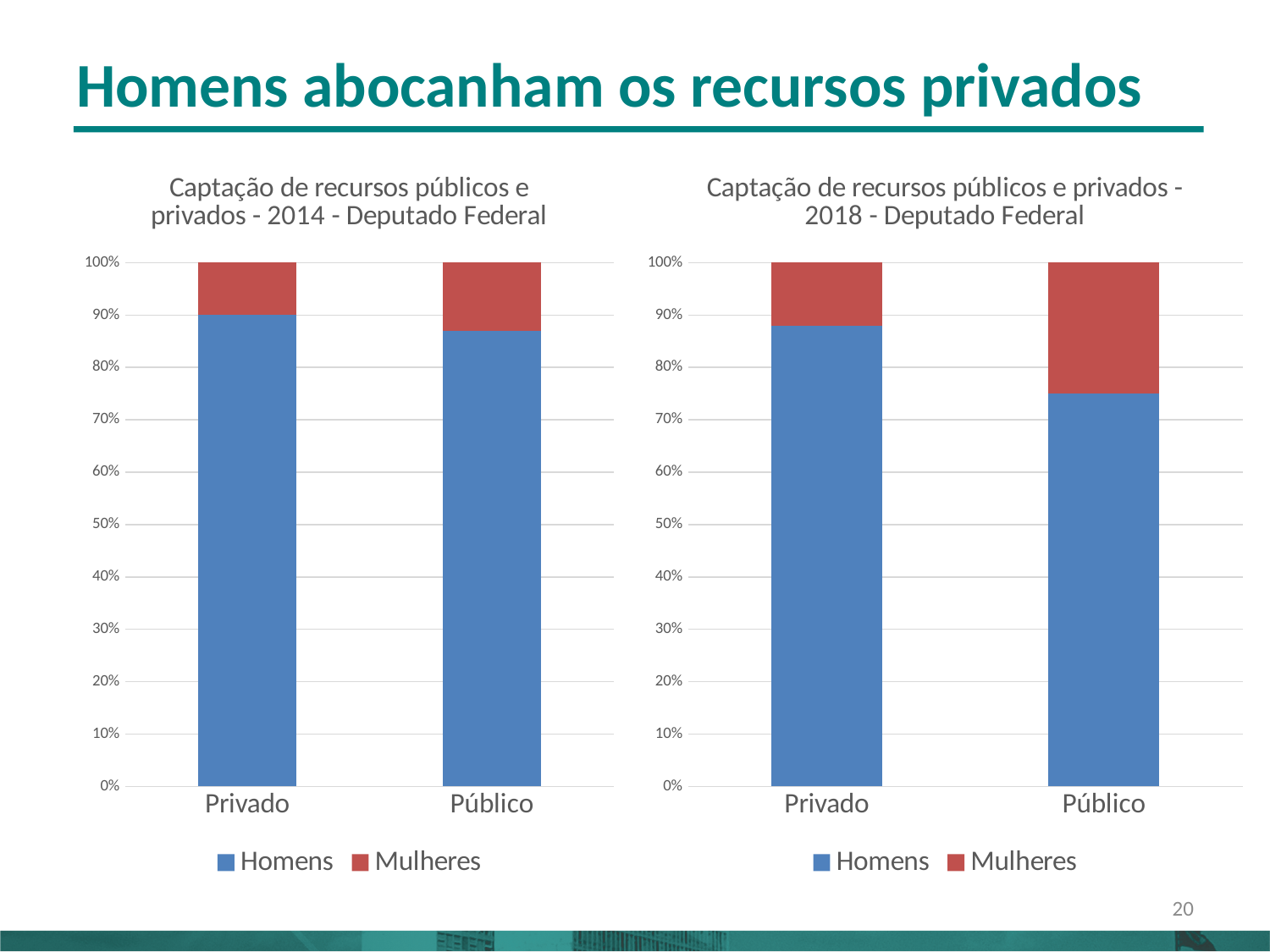
In the right chart (2018), is the Homens share for Público greater or less than 80%? less In the right chart (2018), which category has the larger Mulheres share, Privado or Público? Público How many series does the legend of the left chart (2014) list? 2 Which colour represents Mulheres in the legend of the right chart (2018)? Red What kind of chart is the left chart, 'Captação de recursos públicos e privados - 2014 - Deputado Federal'? Stacked bar chart In the left chart (2014), what is the total height of the Privado stacked bar? 100% In the right chart (2018), is the Homens share for Privado greater or less than 80%? greater In the left chart (2014), is the Homens share for Público greater or less than 80%? greater In the right chart (2018), which category has the highest Homens share? Privado How many categories are shown on the x axis of the right chart (2018)? 2